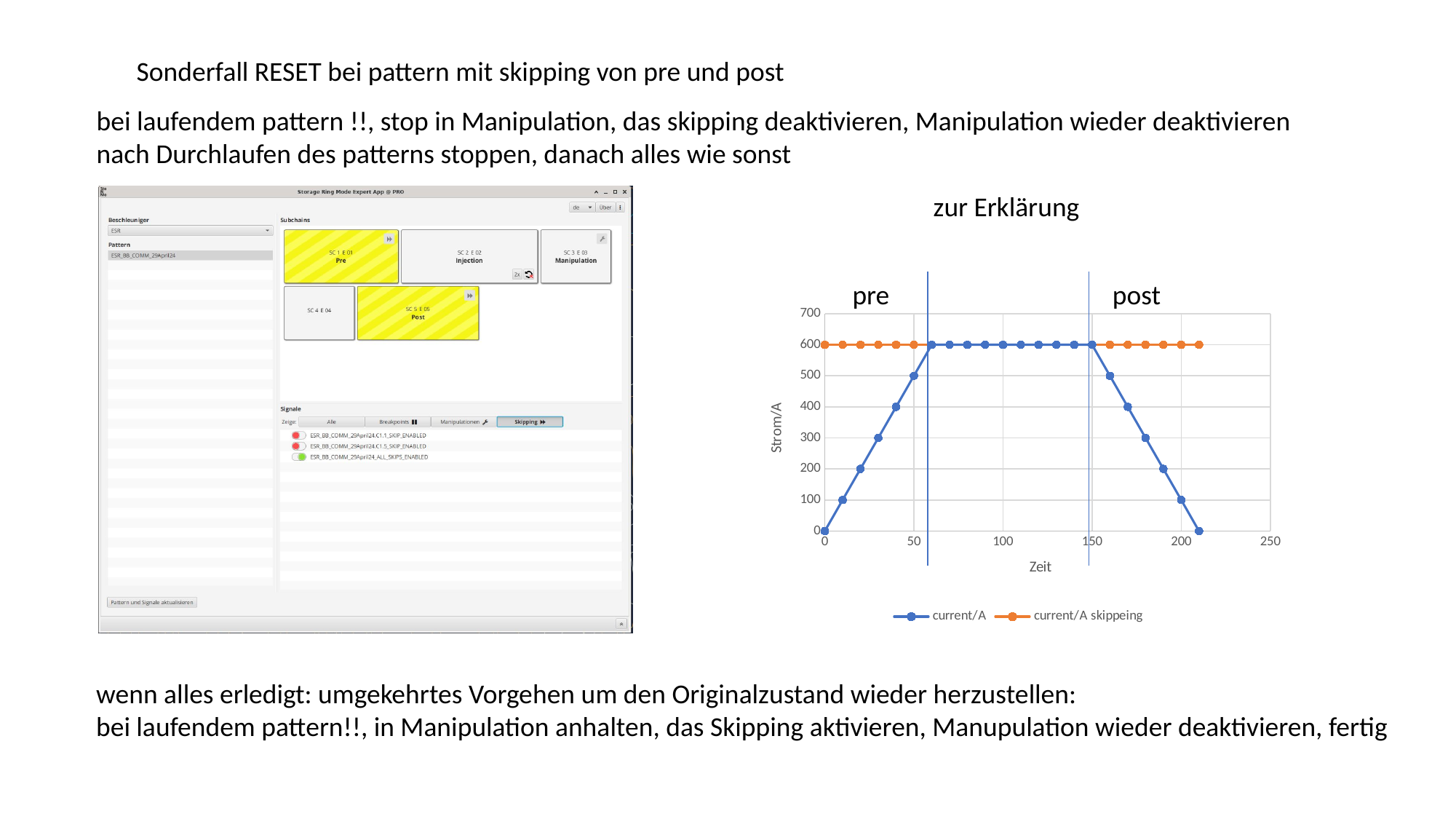
Is the value of current/A at Zeit 20 greater or less than 300? less What is the highest value reached by the current/A series? 600 What are the two series named in the chart legend? current/A and current/A skippeing What kind of chart is shown on the slide? line chart Does the current/A series rise or fall between Zeit 0 and Zeit 50? rise What is the value of current/A skippeing at Zeit 0? 600 What is the value of current/A at Zeit 100? 600 What is the label of the vertical axis of the chart? Strom/A Does the current/A series rise or fall between Zeit 150 and Zeit 200? fall What is the value of current/A at Zeit 50? 500 At Zeit 30, which series has the higher value, current/A or current/A skippeing? current/A skippeing How many series does the chart legend list? 2